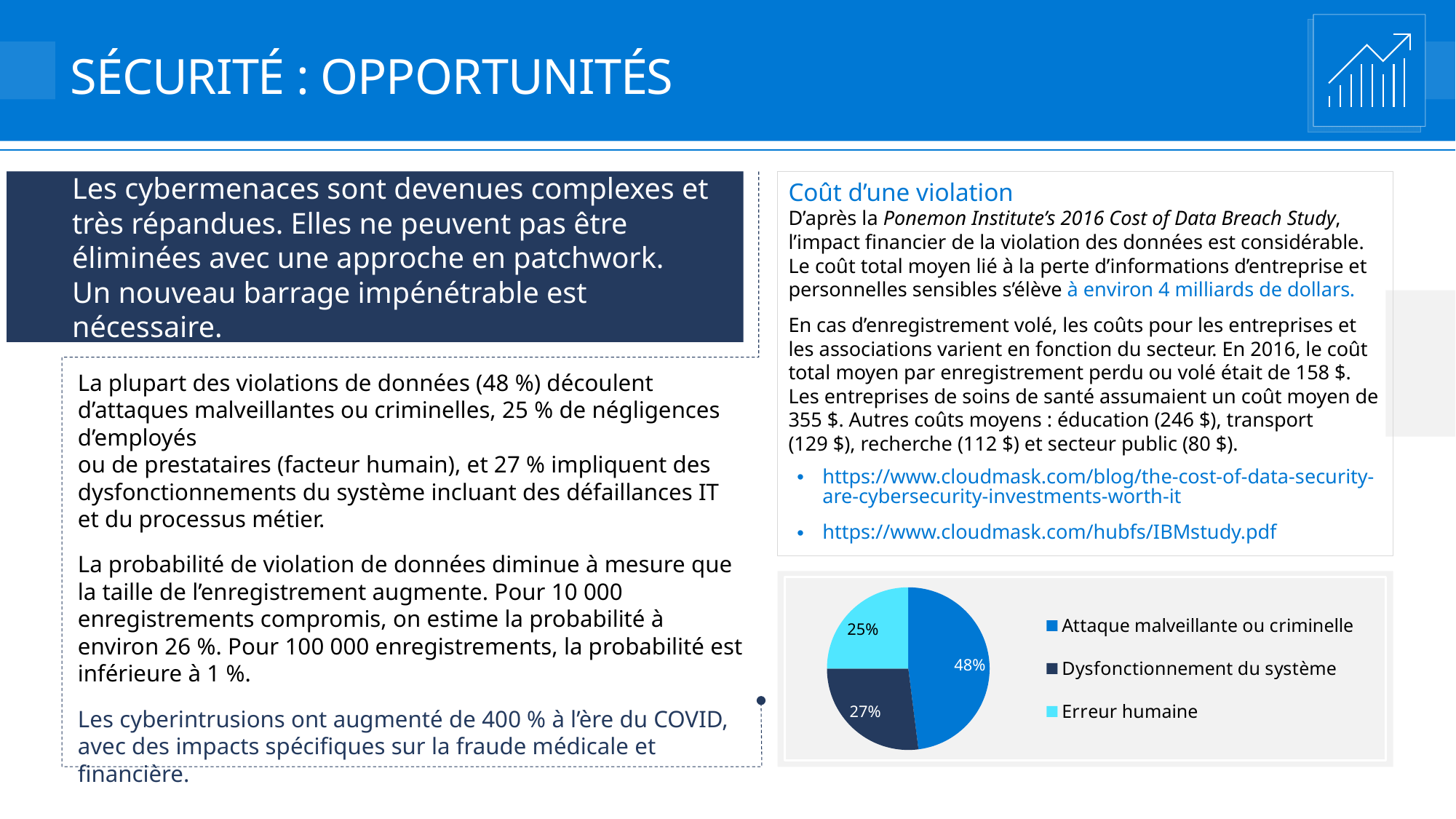
Which category has the largest slice of the pie? Attaque malveillante ou criminelle How many entries does the chart legend list? 3 What share of the pie does "Erreur humaine" represent? 25% What share of the pie does "Attaque malveillante ou criminelle" represent? 48% What share of the pie does "Dysfonctionnement du système" represent? 27% What is the difference in percentage points between "Dysfonctionnement du système" and "Erreur humaine"? 2 Which category has the smallest slice of the pie? Erreur humaine What is the difference in percentage points between "Attaque malveillante ou criminelle" and "Dysfonctionnement du système"? 21 What kind of chart is shown on the slide? Pie chart What colour is the slice for "Erreur humaine" in the pie chart? Light blue (cyan) Which is larger: the slice for "Attaque malveillante ou criminelle" or the slice for "Erreur humaine"? Attaque malveillante ou criminelle How many slices does the pie chart have? 3